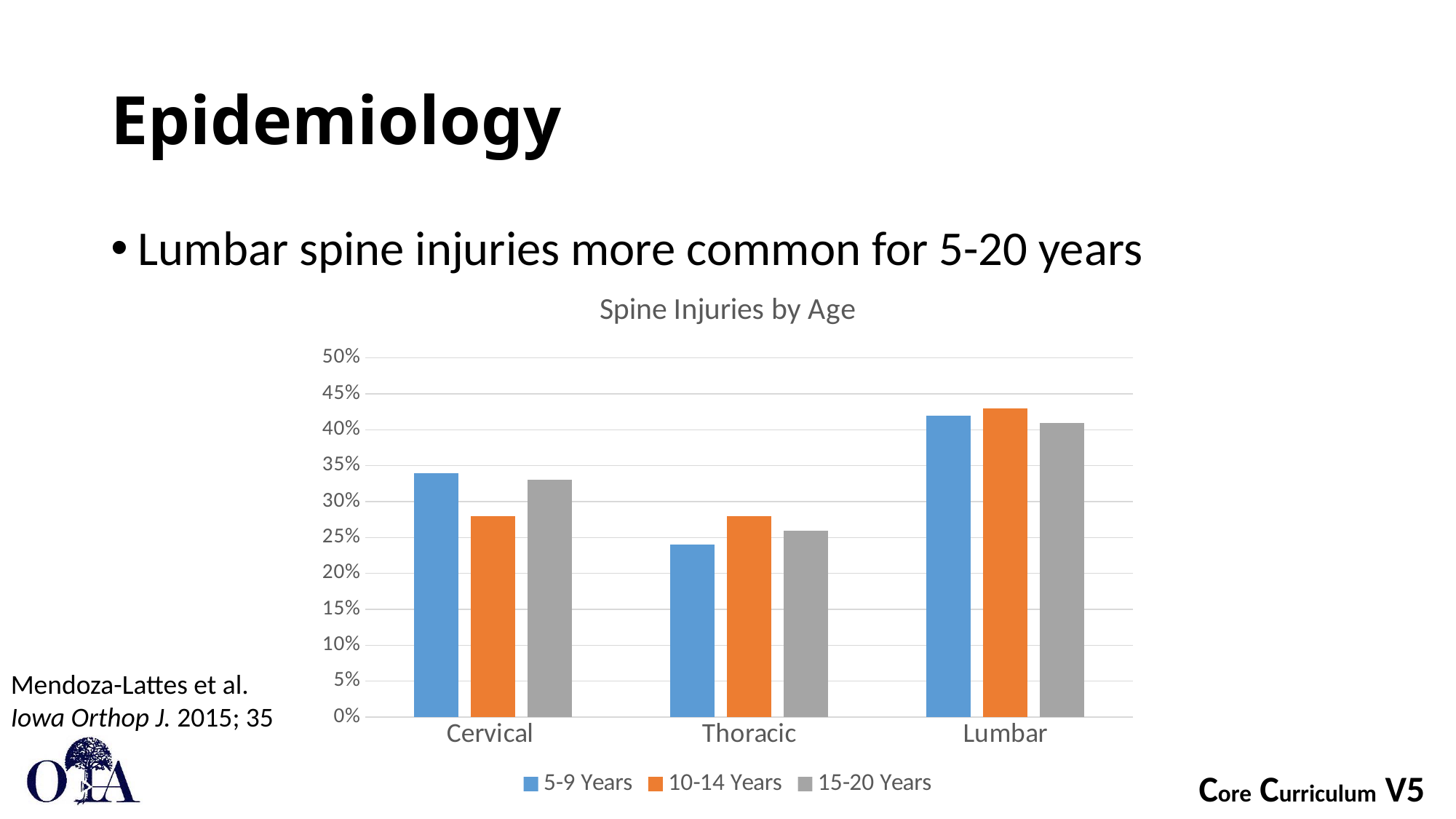
Which category has the lowest value for the 5-9 Years series? Thoracic For Cervical, which is larger: the 5-9 Years value or the 10-14 Years value? 5-9 Years How many series does the legend list? 3 Which series is shown in orange in the legend? 10-14 Years What is the title of the chart? Spine Injuries by Age What kind of chart is shown on the slide? bar chart For Thoracic, which is larger: the 5-9 Years value or the 10-14 Years value? 10-14 Years How many categories are shown on the x axis? 3 Which category has the lowest value for the 15-20 Years series? Thoracic Is the value for Cervical in the 10-14 Years series greater or less than 30%? less Which category has the highest value for the 5-9 Years series? Lumbar Is the value for Lumbar in the 5-9 Years series greater or less than 40%? greater